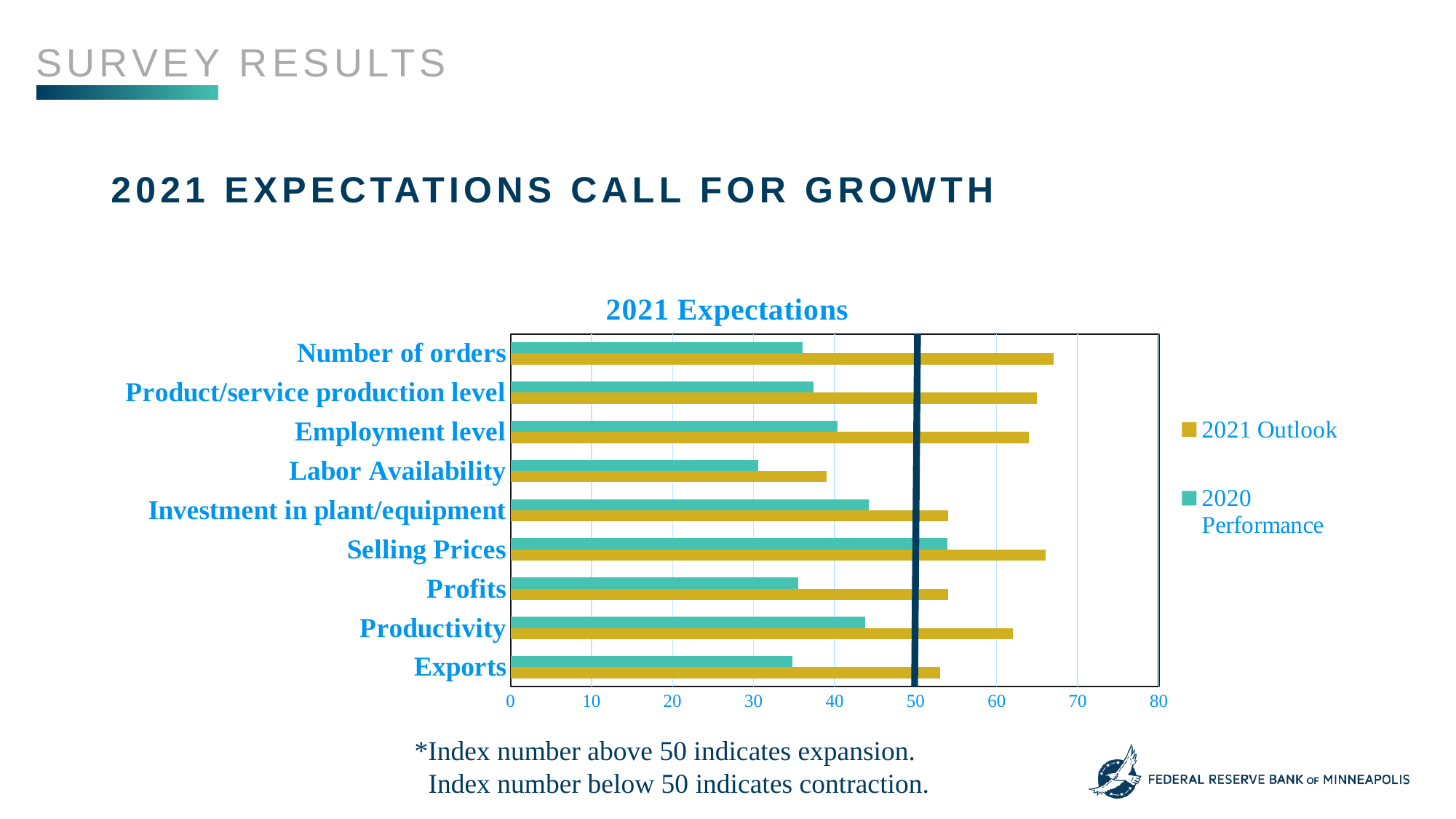
How many series does the legend of the 2021 Expectations chart list? 2 Is the 2020 Performance value for Number of orders greater or less than 40? less Is the 2021 Outlook value for Labor Availability greater or less than 50? less What kind of chart is shown on the slide? bar chart Which category has the highest 2020 Performance value? Selling Prices Is the 2021 Outlook value for Productivity greater or less than 60? greater Which category has the lowest 2021 Outlook value? Labor Availability For Number of orders, which is larger: the 2021 Outlook value or the 2020 Performance value? 2021 Outlook Which category has the lowest 2020 Performance value? Labor Availability What is the title of the chart? 2021 Expectations How many categories are plotted in the 2021 Expectations chart? 9